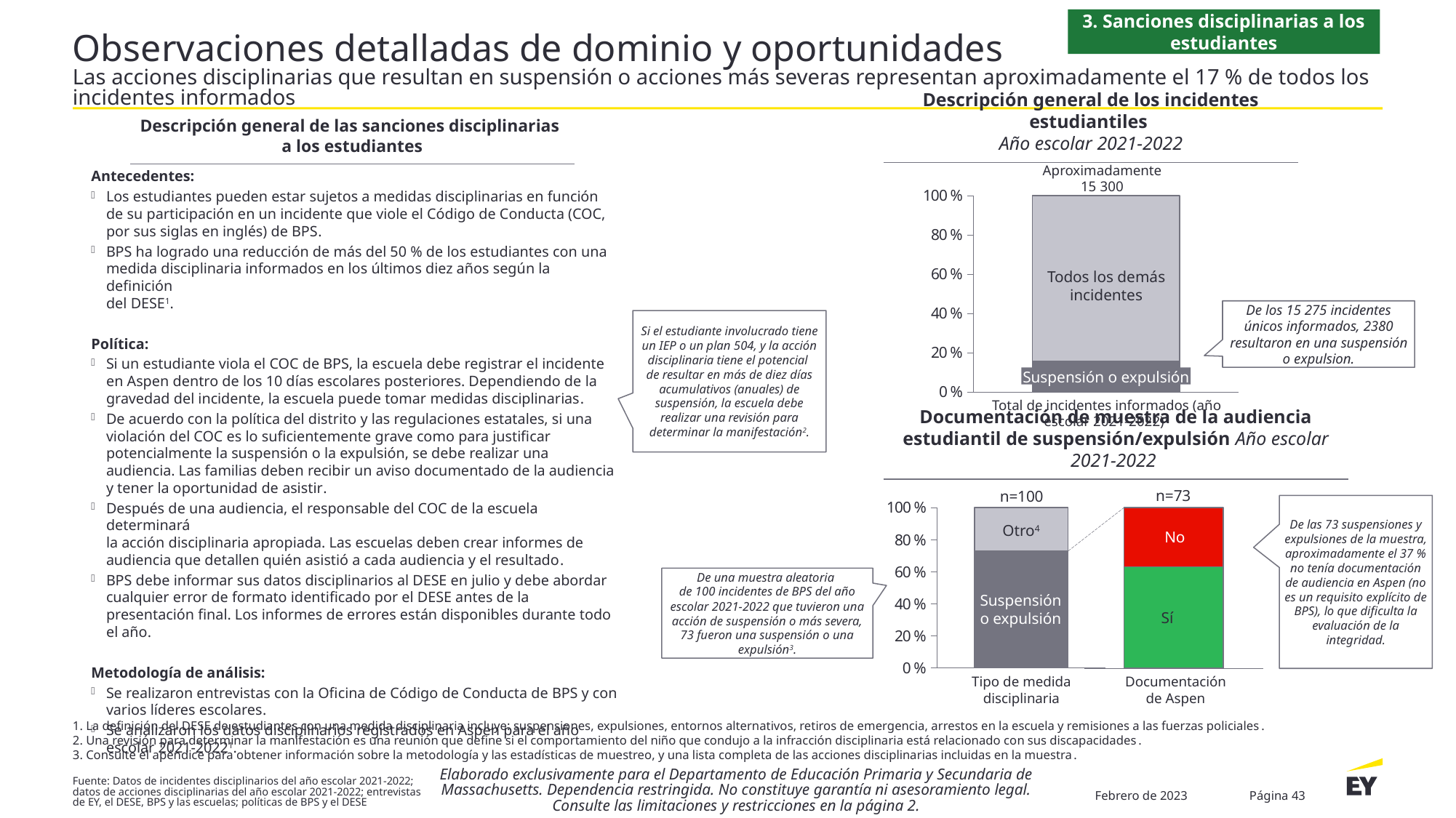
In the bottom-right chart 'Documentación de muestra de la audiencia estudiantil de suspensión/expulsión', what sample size is printed above the 'Documentación de Aspen' bar? n=73 What kind of chart is the top-right chart titled 'Descripción general de los incidentes estudiantiles'? bar chart How many bars are shown in the bottom-right chart 'Documentación de muestra de la audiencia estudiantil de suspensión/expulsión'? 2 In the bottom-right chart 'Documentación de muestra de la audiencia estudiantil de suspensión/expulsión', which segment of the 'Documentación de Aspen' bar is larger: 'Sí' or 'No'? Sí In the top-right chart 'Descripción general de los incidentes estudiantiles', which segment is larger: 'Todos los demás incidentes' or 'Suspensión o expulsión'? Todos los demás incidentes In the top-right chart 'Descripción general de los incidentes estudiantiles', is the share for 'Todos los demás incidentes' greater or less than 80 %? greater In the top-right chart 'Descripción general de los incidentes estudiantiles', what approximate total number of incidents is printed above the bar? Aproximadamente 15 300 In the bottom-right chart 'Documentación de muestra de la audiencia estudiantil de suspensión/expulsión', is the share for 'Suspensión o expulsión' in the 'Tipo de medida disciplinaria' bar greater or less than 60 %? greater In the top-right chart 'Descripción general de los incidentes estudiantiles', is the share for 'Suspensión o expulsión' greater or less than 20 %? less What kind of chart is the bottom-right chart titled 'Documentación de muestra de la audiencia estudiantil de suspensión/expulsión'? bar chart In the bottom-right chart 'Documentación de muestra de la audiencia estudiantil de suspensión/expulsión', what sample size is printed above the 'Tipo de medida disciplinaria' bar? n=100